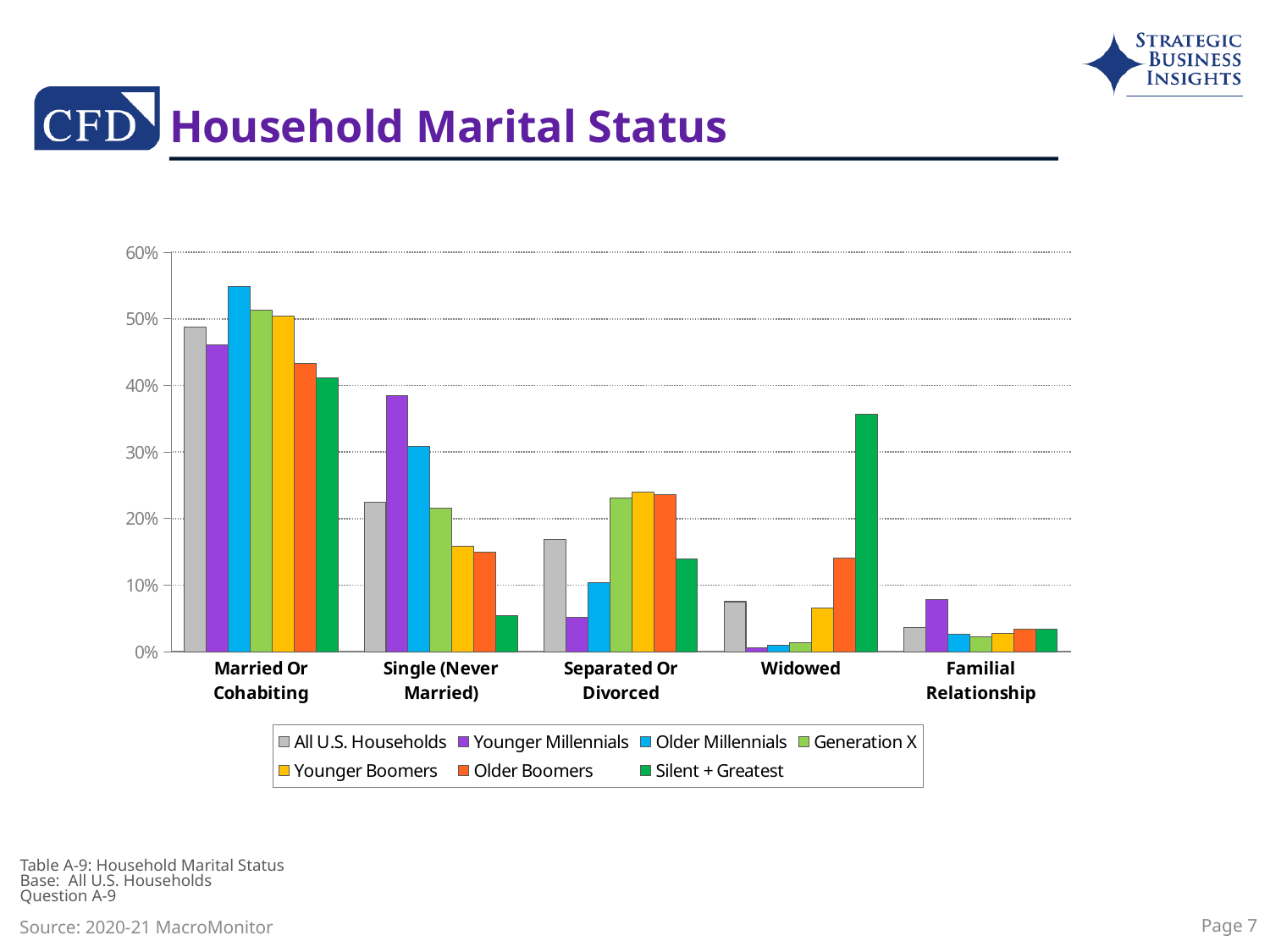
Which series has the highest value for Single (Never Married)? Younger Millennials What kind of chart is shown on the slide? bar chart Which series has the highest value for Widowed? Silent + Greatest What is the title of the chart? Household Marital Status For Widowed, which is larger: Older Boomers or Younger Boomers? Older Boomers Is the value for Silent + Greatest in Widowed greater or less than 30%? greater How many series does the legend list? 7 Is the value for Older Millennials in Married Or Cohabiting greater or less than 50%? greater For Single (Never Married), which is larger: Younger Millennials or Older Millennials? Younger Millennials Is the value for Younger Millennials in Separated Or Divorced greater or less than 10%? less How many marital status categories are shown on the x axis? 5 Which series has the lowest value for Single (Never Married)? Silent + Greatest